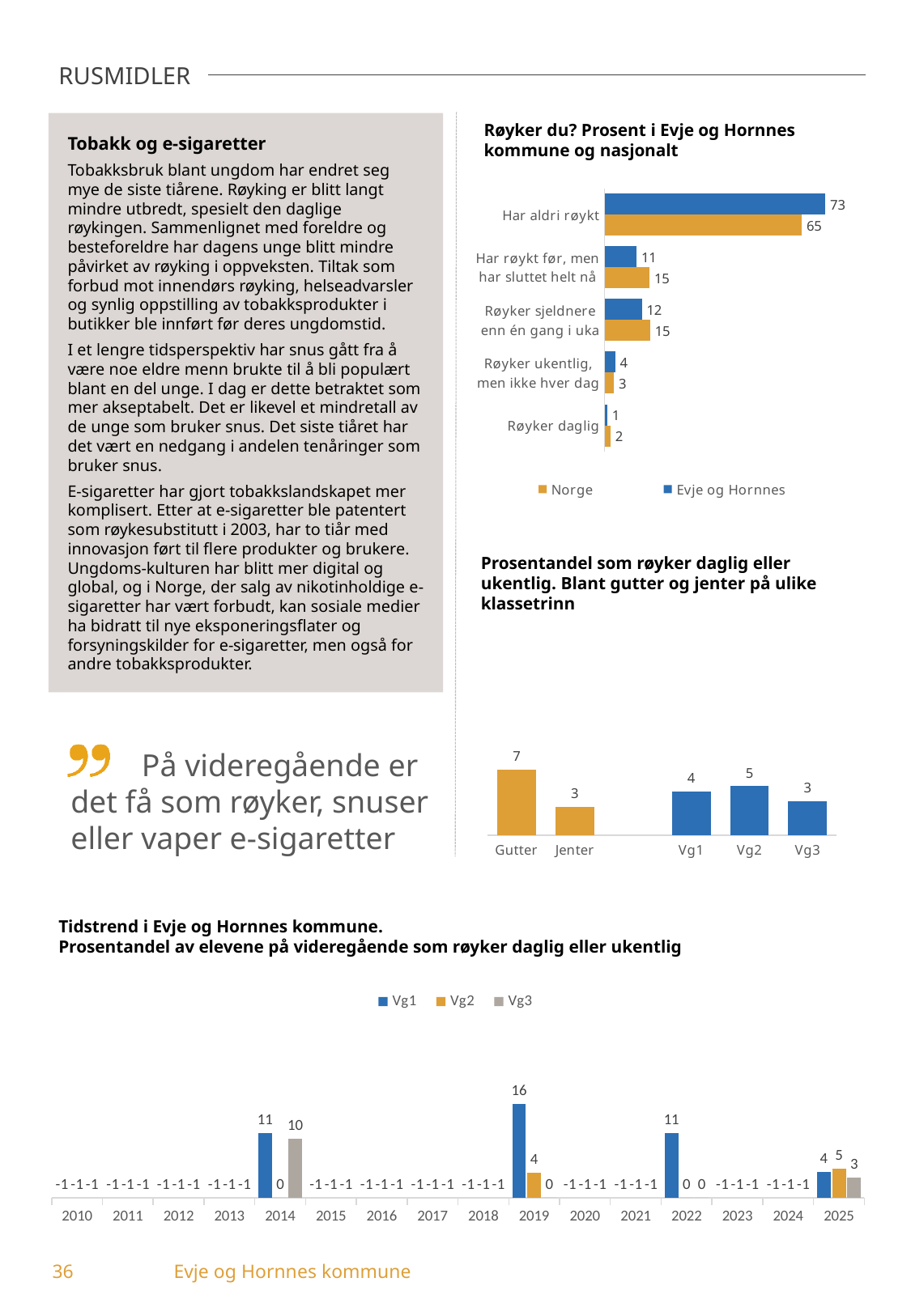
In the chart 'Prosentandel som røyker daglig eller ukentlig', what is the value for Gutter? 7 In the chart 'Prosentandel som røyker daglig eller ukentlig', how many categories are shown? 5 In the chart 'Røyker du? Prosent i Evje og Hornnes kommune og nasjonalt', how many series does the legend list? 2 In the chart 'Prosentandel som røyker daglig eller ukentlig', which category has the highest value? Gutter In the chart 'Røyker du? Prosent i Evje og Hornnes kommune og nasjonalt', which category has the lowest value for Evje og Hornnes? Røyker daglig In the chart 'Røyker du? Prosent i Evje og Hornnes kommune og nasjonalt', which colour represents Norge? Orange In the chart 'Røyker du? Prosent i Evje og Hornnes kommune og nasjonalt', what is the difference between Evje og Hornnes and Norge for 'Har aldri røykt'? 8 In the chart 'Tidstrend i Evje og Hornnes kommune', what is the value for Vg3 in 2014? 10 What kind of chart is 'Tidstrend i Evje og Hornnes kommune'? Bar chart In the chart 'Tidstrend i Evje og Hornnes kommune', what is the value for Vg1 in 2019? 16 In the chart 'Røyker du? Prosent i Evje og Hornnes kommune og nasjonalt', what is the value for Evje og Hornnes for 'Har aldri røykt'? 73 In the chart 'Røyker du? Prosent i Evje og Hornnes kommune og nasjonalt', what is the value for Norge for 'Har røykt før, men har sluttet helt nå'? 15